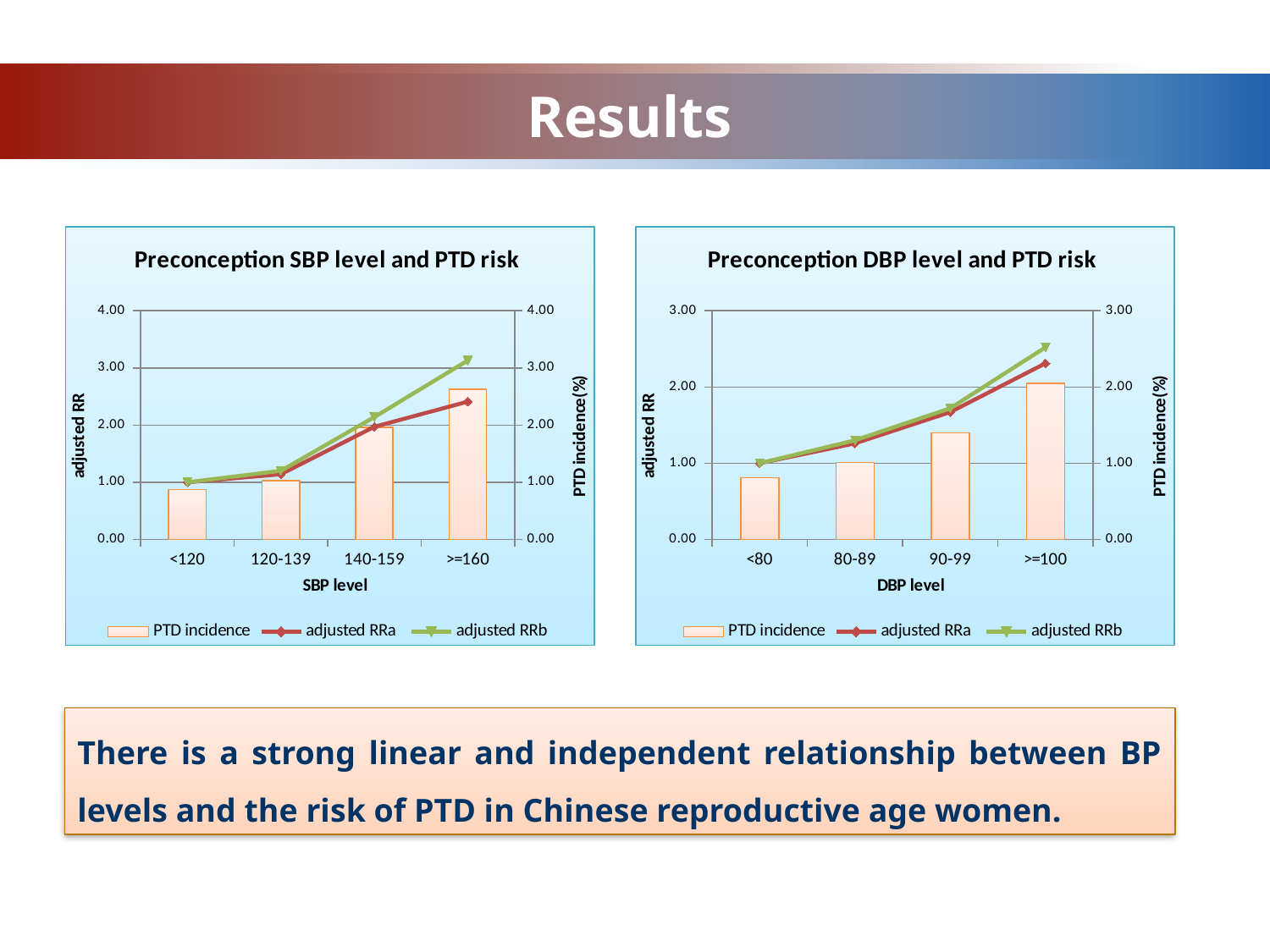
In the 'Preconception SBP level and PTD risk' chart, which SBP level has the highest PTD incidence bar? >=160 In the 'Preconception SBP level and PTD risk' chart, is the PTD incidence bar for <120 greater or less than 1.00? less In the 'Preconception SBP level and PTD risk' chart, is the adjusted RRb value for >=160 greater or less than 3.00? greater In the 'Preconception DBP level and PTD risk' chart, which DBP level has the lowest PTD incidence bar? <80 In the 'Preconception SBP level and PTD risk' chart, at the >=160 level, which is larger: adjusted RRa or adjusted RRb? adjusted RRb In the 'Preconception SBP level and PTD risk' chart, how many SBP level categories are shown on the x axis? 4 In the 'Preconception DBP level and PTD risk' chart, how many series does the legend list? 3 In the 'Preconception DBP level and PTD risk' chart, do the adjusted RRa values rise or fall as DBP level increases? rise What kind of chart is the 'Preconception SBP level and PTD risk' chart? A combined bar and line chart What is the title of the chart on the right of the slide? Preconception DBP level and PTD risk In the 'Preconception SBP level and PTD risk' chart, what is the adjusted RRa value for the <120 level? 1.00 In the 'Preconception DBP level and PTD risk' chart, is the adjusted RRb value for >=100 greater or less than 2.00? greater